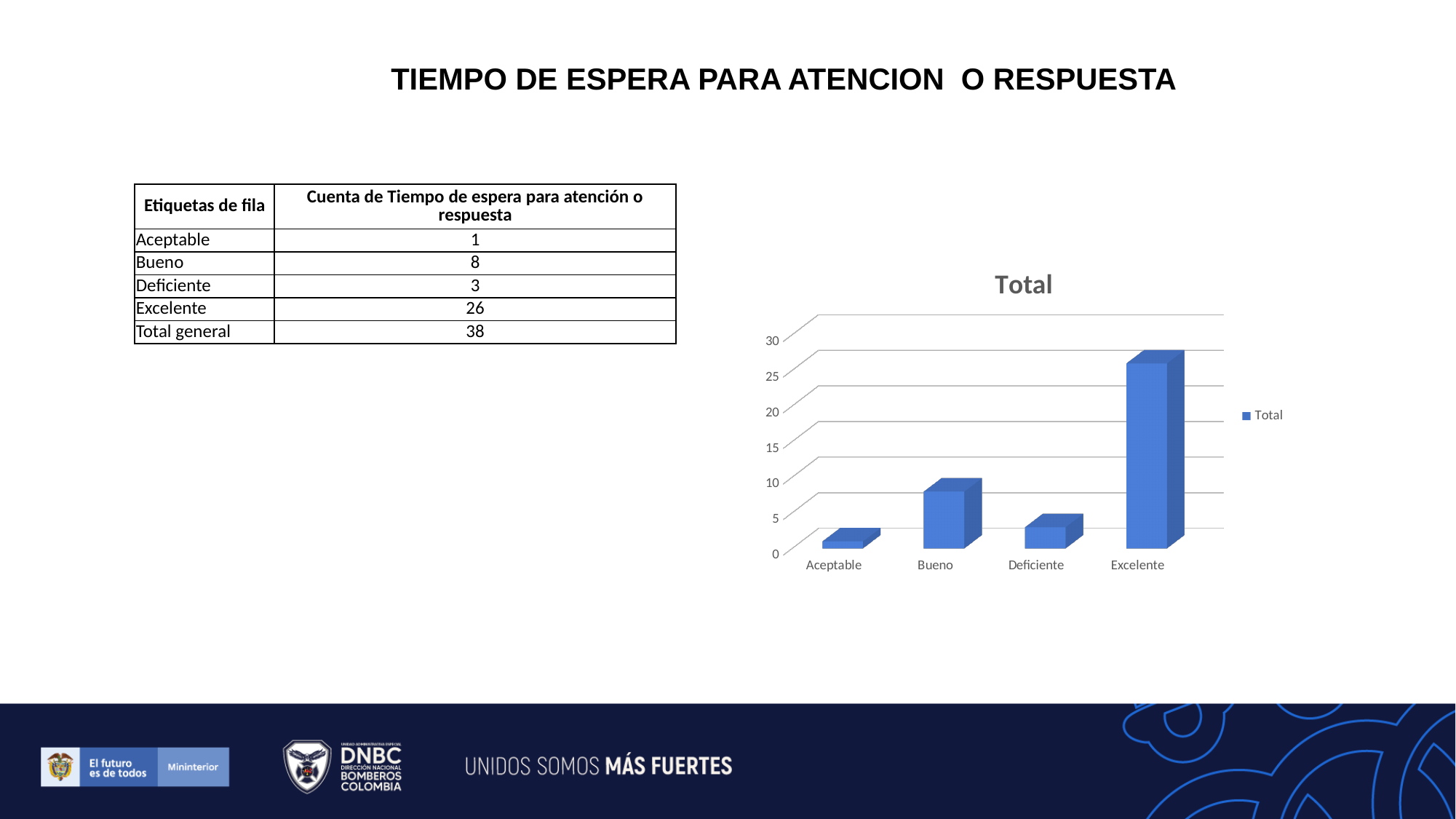
According to the table on the slide, what is the Total general? 38 Which is larger in the chart, the bar for Bueno or the bar for Deficiente? Bueno How many series does the chart legend list? 1 According to the table on the slide, what is the count for Bueno? 8 Is the value for Excelente in the chart greater or less than 20? greater What is the title of the chart? Total How many categories are shown on the x axis of the chart? 4 What type of chart is shown on the slide? bar chart Which category has the lowest bar in the chart? Aceptable According to the table on the slide, what is the count for Excelente? 26 Which category has the highest bar in the chart? Excelente Is the value for Deficiente in the chart greater or less than 5? less